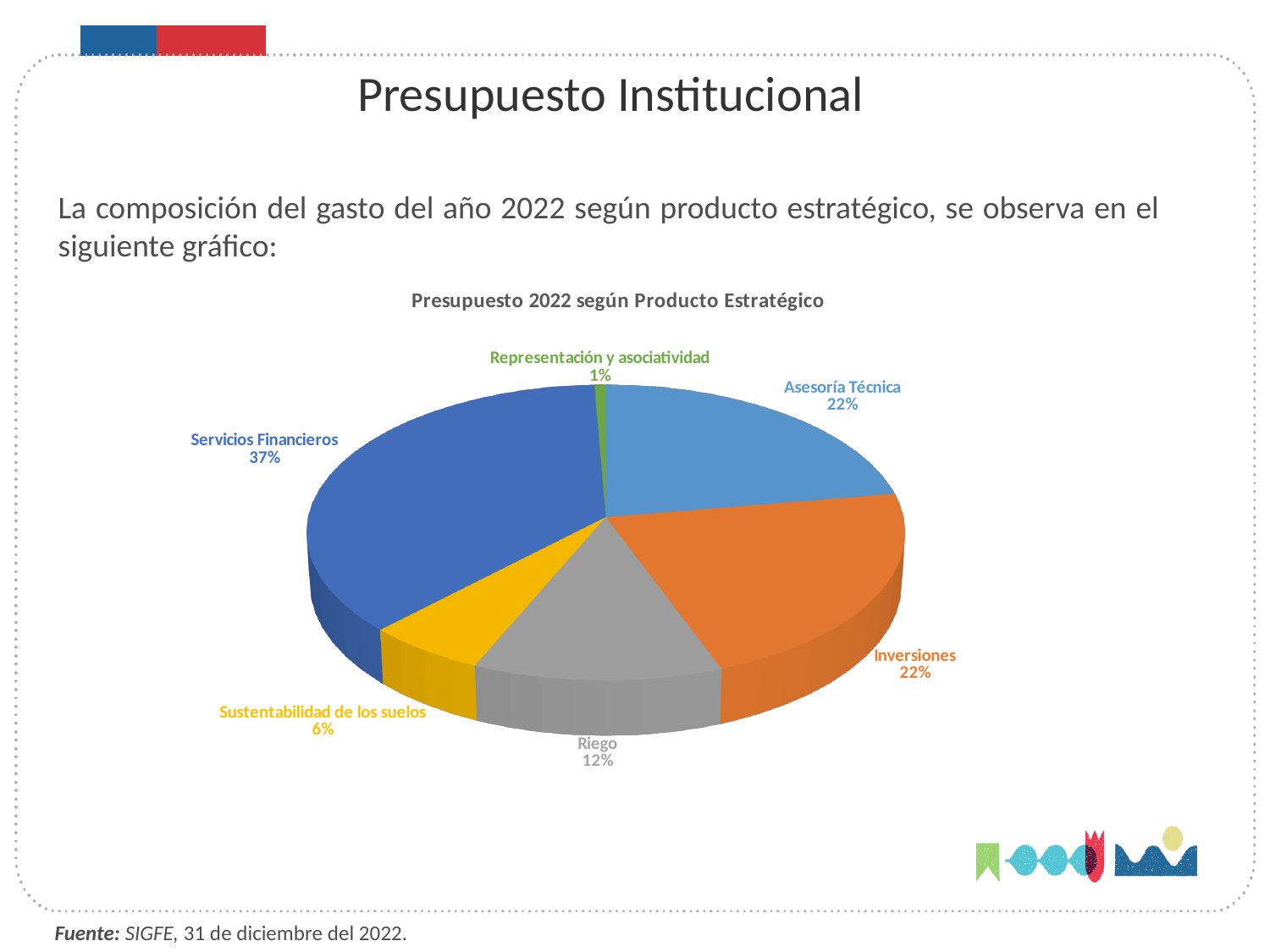
Which category has the smallest share of the pie? Representación y asociatividad What kind of chart is shown on the slide? Pie chart How many categories are shown in the pie chart? 6 What share of the pie does Riego represent? 12% Which is larger, the share for Riego or the share for Sustentabilidad de los suelos? Riego What share of the pie does Representación y asociatividad represent? 1% Which category has the largest share of the pie? Servicios Financieros What share of the pie does Sustentabilidad de los suelos represent? 6% What share of the pie does Servicios Financieros represent? 37% What is the title of the chart? Presupuesto 2022 según Producto Estratégico What colour is the Inversiones slice? Orange What is the difference in percentage points between Servicios Financieros and Riego? 25